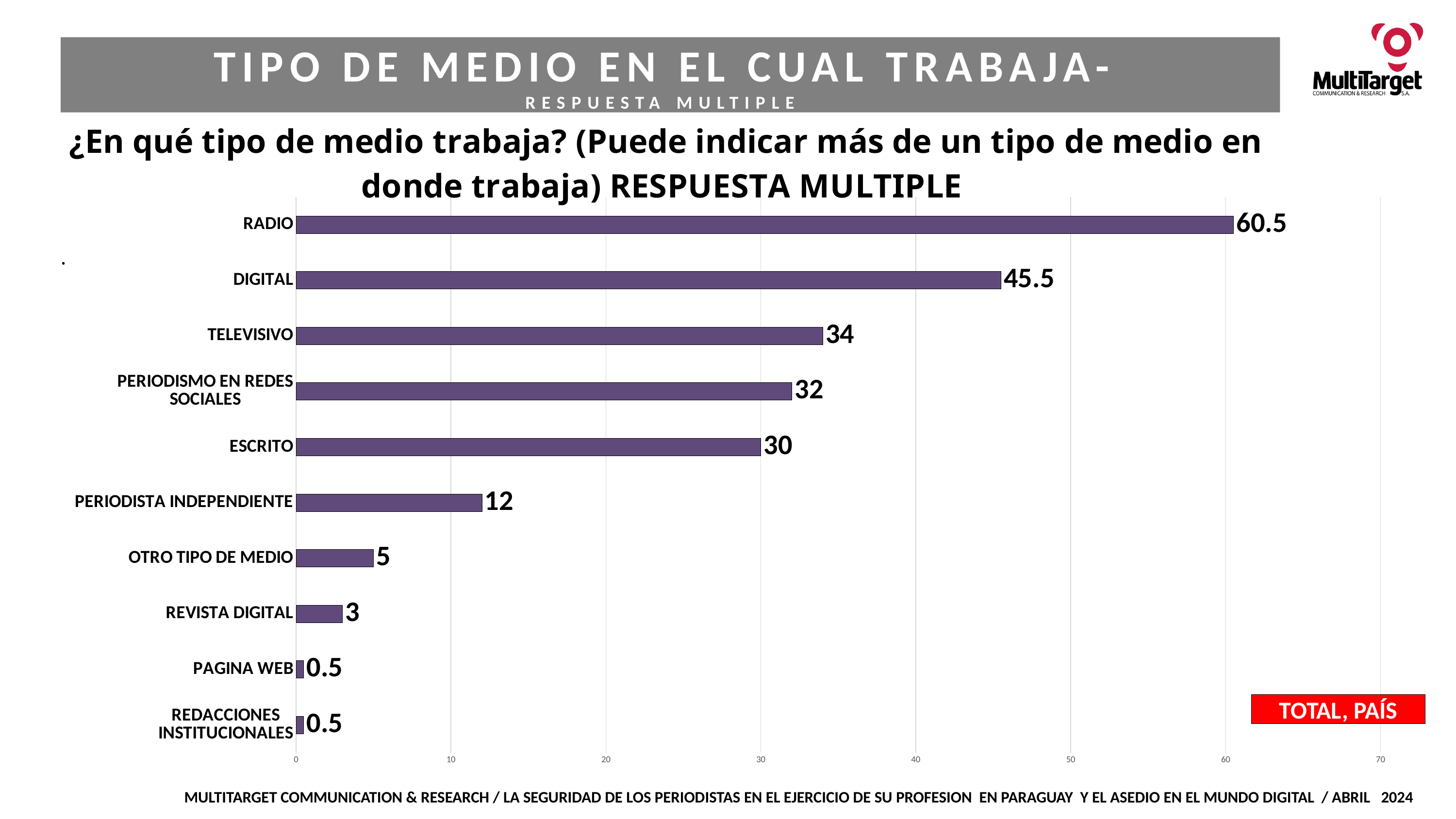
What is the value for RADIO? 60.5 What is the value for PERIODISMO EN REDES SOCIALES? 32 Which category has the highest value? RADIO What kind of chart is shown on the slide? bar chart What is the value for REVISTA DIGITAL? 3 What is the value for PAGINA WEB? 0.5 What is the difference between the values for RADIO and DIGITAL? 15 Is the value for DIGITAL greater or less than 40? greater What is the text in the red box at the bottom right of the chart? TOTAL, PAÍS What is the difference between the values for TELEVISIVO and ESCRITO? 4 Which is larger, the value for PERIODISTA INDEPENDIENTE or the value for OTRO TIPO DE MEDIO? PERIODISTA INDEPENDIENTE How many categories are shown in the chart? 10